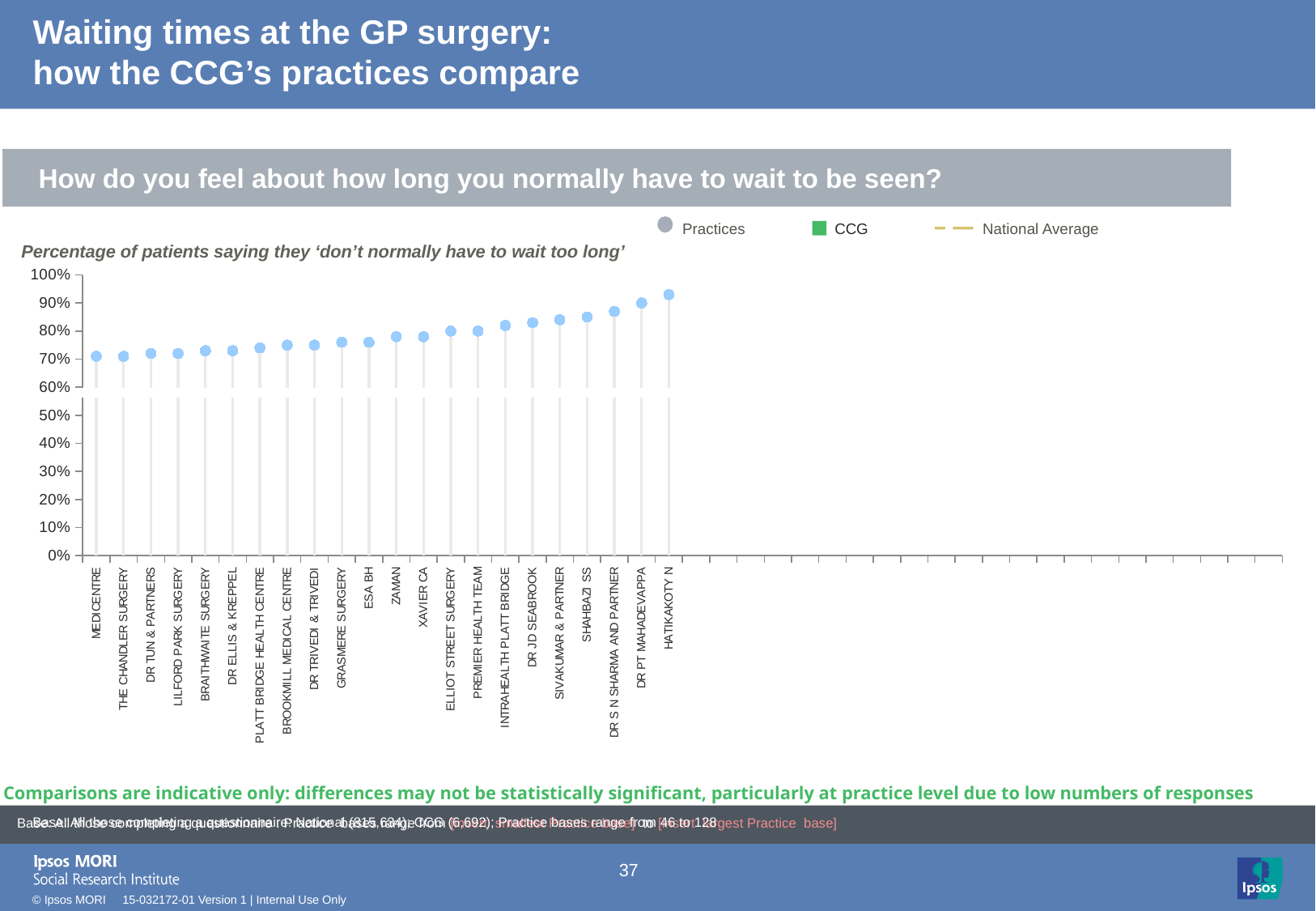
Is the value for HATIKAKOTY N greater or less than 90%? greater Is the value for DR S N SHARMA AND PARTNER greater or less than 80%? greater What question is the chart reporting responses to? How do you feel about how long you normally have to wait to be seen? Which has the higher value, DR JD SEABROOK or BRAITHWAITE SURGERY? DR JD SEABROOK How many entries does the chart legend list? 3 Which has the higher value, HATIKAKOTY N or MEDICENTRE? HATIKAKOTY N What kind of chart is shown on the slide? Dot chart (lollipop chart) Which practice has the highest percentage of patients saying they 'don't normally have to wait too long'? HATIKAKOTY N Is the value for MEDICENTRE greater or less than 60%? greater Do the values rise or fall moving from left to right across the practices? rise How many practices are plotted on the chart? 22